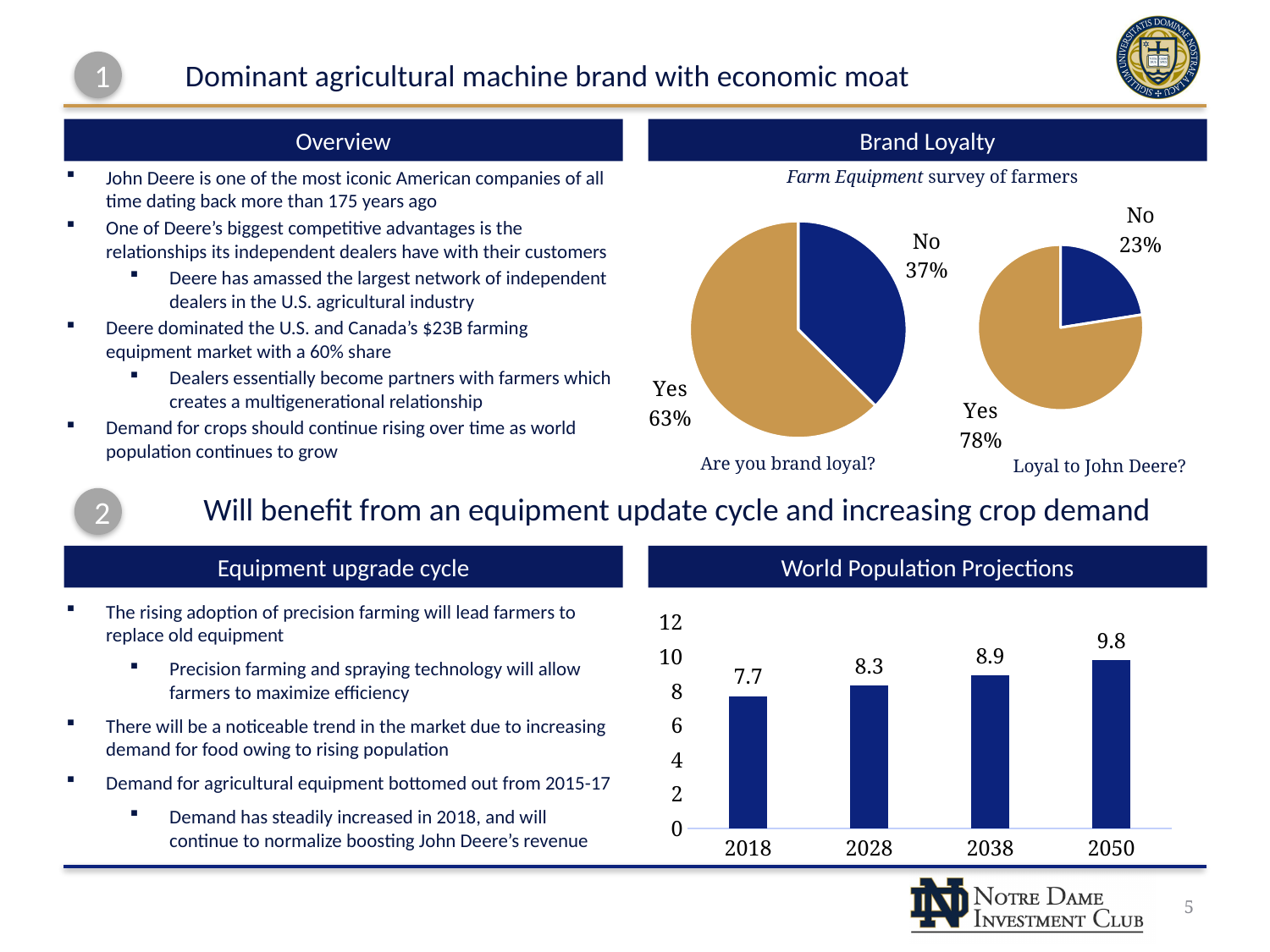
In the World Population Projections chart, which year has the lowest value? 2018 In the 'Are you brand loyal?' pie chart, what share of farmers answered No? 37% In the World Population Projections chart, what is the value for 2050? 9.8 In the World Population Projections chart, do the values rise or fall from 2018 to 2050? Rise In the World Population Projections chart, how many years are shown on the x axis? 4 In the 'Loyal to John Deere?' pie chart, what share of farmers answered No? 23% What type of chart is used for the World Population Projections? Bar chart In the 'Are you brand loyal?' pie chart, what share of farmers answered Yes? 63% In the World Population Projections chart, what is the value for 2028? 8.3 In the World Population Projections chart, what is the difference between the 2050 and 2018 values? 2.1 In the 'Loyal to John Deere?' pie chart, which answer has the larger slice? Yes